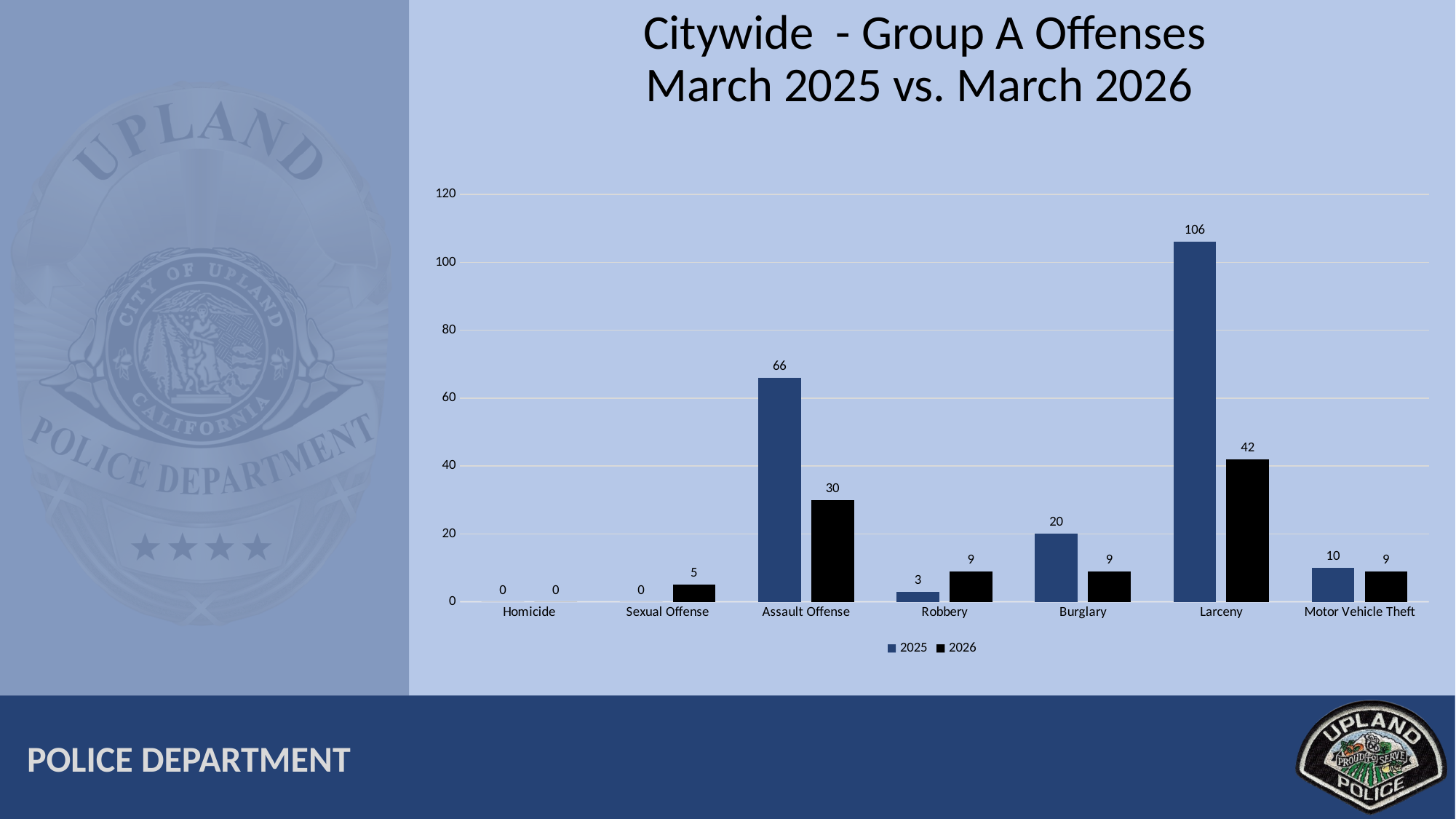
How many offense categories are shown on the x axis? 7 What is the 2026 value for Assault Offense? 30 What is the difference between the 2025 and 2026 values for Larceny? 64 Which is larger for Burglary, the 2025 value or the 2026 value? 2025 What is the 2025 value for Larceny? 106 How many series does the legend list? 2 What kind of chart is shown on the slide? Bar chart Which category has the highest 2025 value? Larceny What is the difference between the 2025 and 2026 values for Assault Offense? 36 Is the 2025 value for Larceny greater or less than 100? greater What is the 2026 value for Robbery? 9 Which category has the lowest 2026 value? Homicide